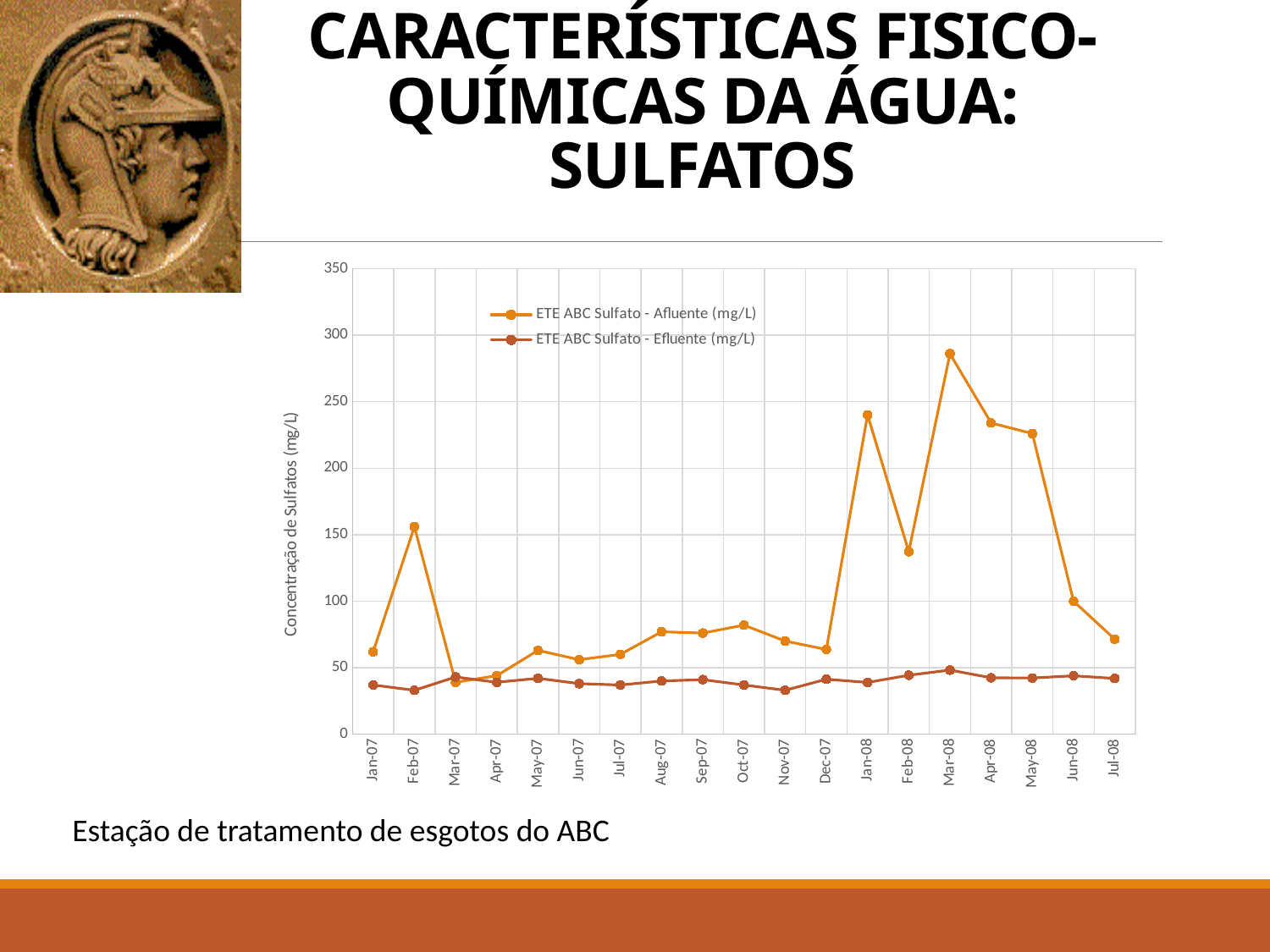
Is the value for ETE ABC Sulfato - Efluente (mg/L) in Jan-08 greater or less than 50? less Does the ETE ABC Sulfato - Afluente (mg/L) series rise or fall from Mar-08 to Jul-08? fall Which series is drawn in the darker red-brown colour? ETE ABC Sulfato - Efluente (mg/L) How many months are plotted along the x axis? 19 How many series does the legend list? 2 What kind of chart is shown on the slide? line chart Is the value for ETE ABC Sulfato - Afluente (mg/L) in Feb-07 greater or less than 100? greater In Jan-08, which series has the larger value: ETE ABC Sulfato - Afluente (mg/L) or ETE ABC Sulfato - Efluente (mg/L)? ETE ABC Sulfato - Afluente (mg/L) In which month does the ETE ABC Sulfato - Afluente (mg/L) series reach its highest value? Mar-08 What is the label of the vertical axis? Concentração de Sulfatos (mg/L) Is the value for ETE ABC Sulfato - Afluente (mg/L) in Jan-08 greater or less than 200? greater